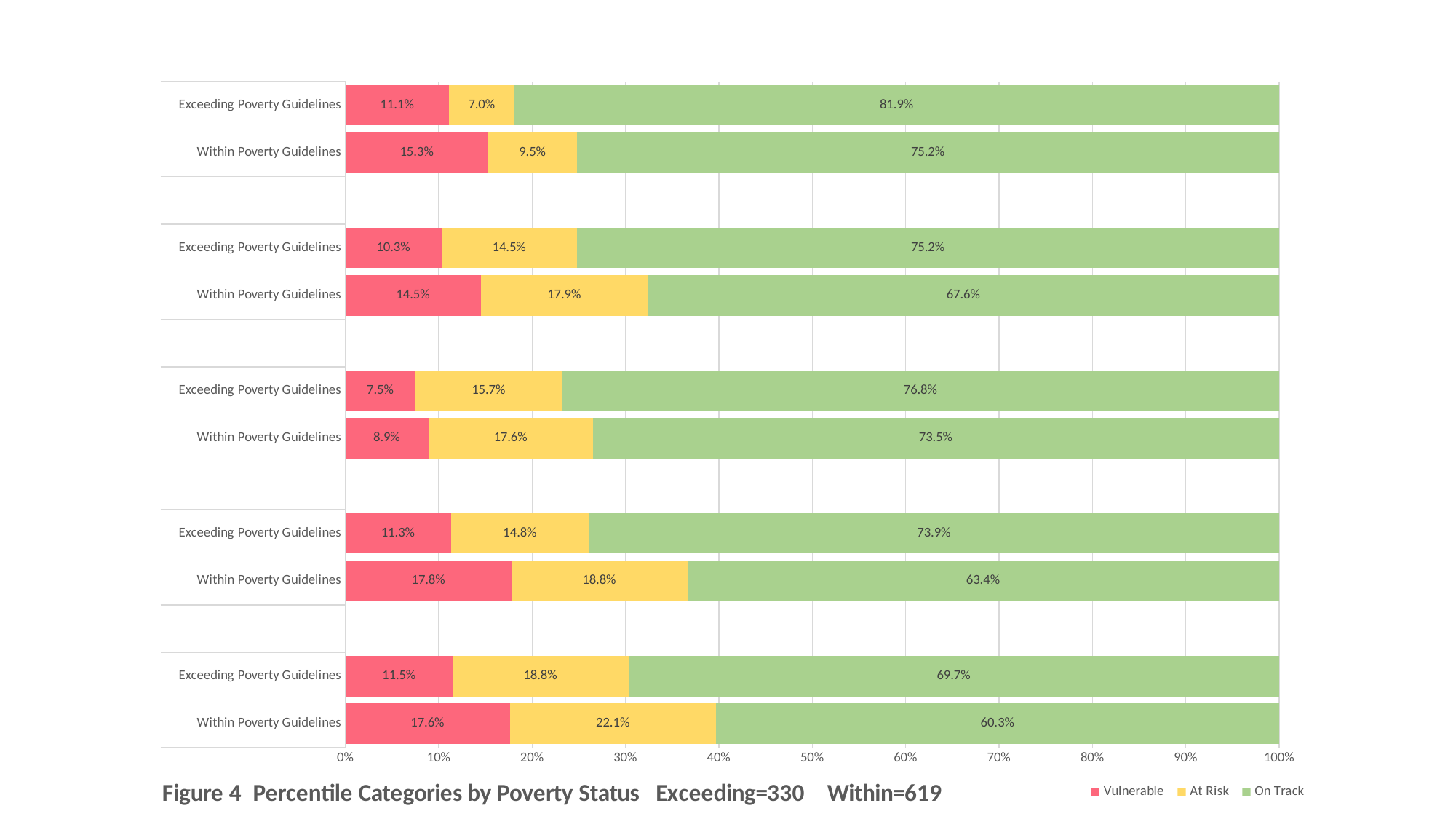
What are the three legend entries? Vulnerable, At Risk, On Track What is the Vulnerable value for the Exceeding Poverty Guidelines bar in the third group from the top? 7.5% What is the At Risk value for the bottom Within Poverty Guidelines bar? 22.1% How many series does the legend list? 3 What is the title of the figure shown below the chart? Figure 4 Percentile Categories by Poverty Status Exceeding=330 Within=619 How many bars are plotted in the chart? 10 Which bar has the highest On Track value? The topmost Exceeding Poverty Guidelines bar (81.9%) In the bottom group, which bar has the larger Vulnerable value, Exceeding Poverty Guidelines or Within Poverty Guidelines? Within Poverty Guidelines What kind of chart is shown on the slide? Stacked bar chart In the top group, what is the difference in On Track values between the Exceeding Poverty Guidelines bar and the Within Poverty Guidelines bar? 6.7 percentage points Which bar has the lowest On Track value? The bottom Within Poverty Guidelines bar (60.3%) What is the On Track value for the topmost Exceeding Poverty Guidelines bar? 81.9%